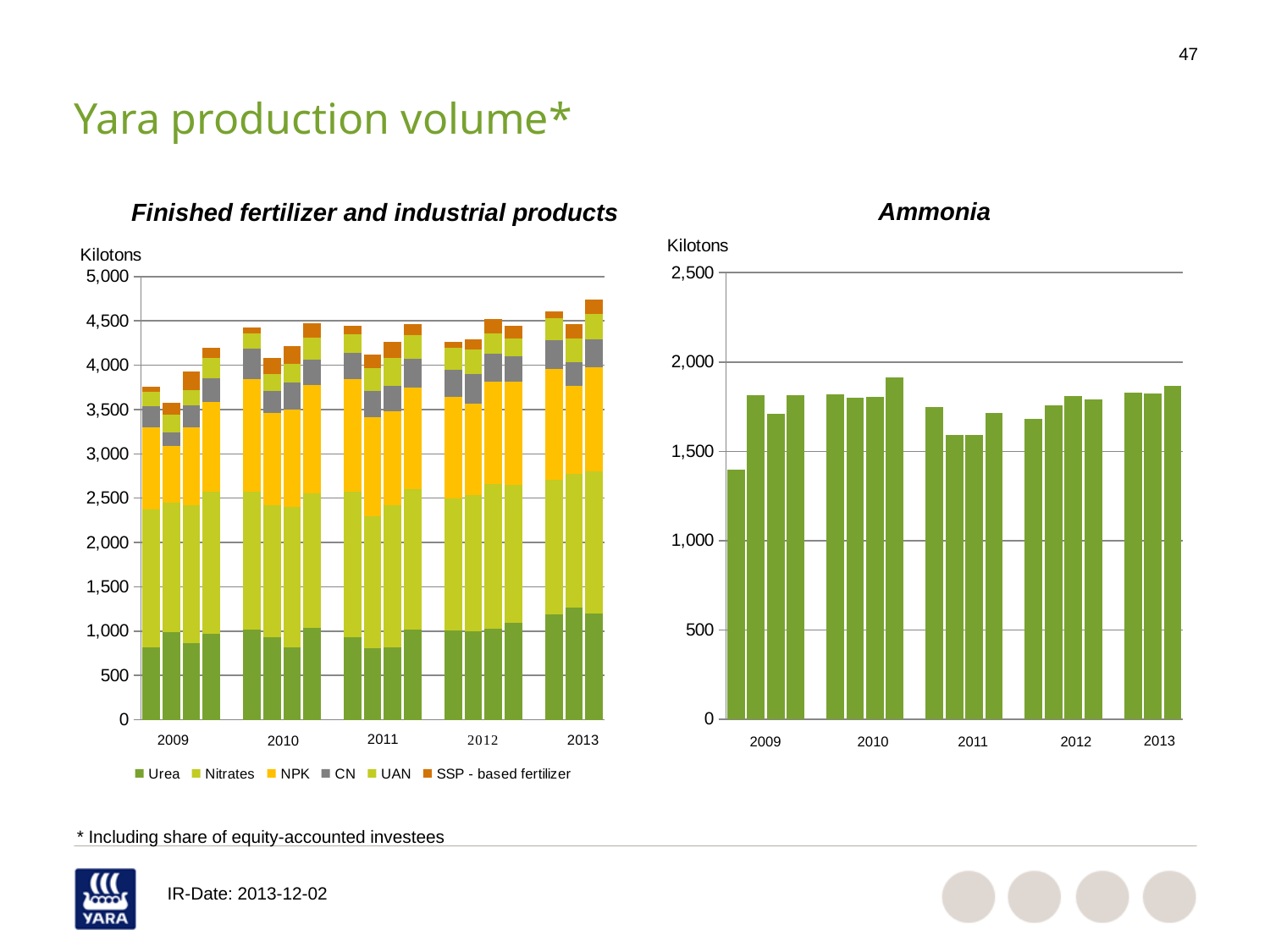
In the Ammonia chart, which bar is the lowest? the first bar of 2009 What kind of chart is the Ammonia chart on the right? bar chart In the Finished fertilizer and industrial products chart, is the total for the first bar of 2009 greater or less than 4,000? less In the Ammonia chart, is the value for the last bar of 2010 greater or less than 2,000? less In the Finished fertilizer and industrial products chart, is the total for the last bar of 2013 greater or less than 4,500? greater How many bars are plotted in the Finished fertilizer and industrial products chart? 19 In the Finished fertilizer and industrial products chart, which is larger: the total for the first bar of 2009 or the total for the last bar of 2013? the last bar of 2013 What kind of chart is the Finished fertilizer and industrial products chart on the left? stacked bar chart What unit is shown on the y axis of both charts? Kilotons How many series does the legend of the Finished fertilizer and industrial products chart list? 6 How many bars are plotted in the Ammonia chart? 19